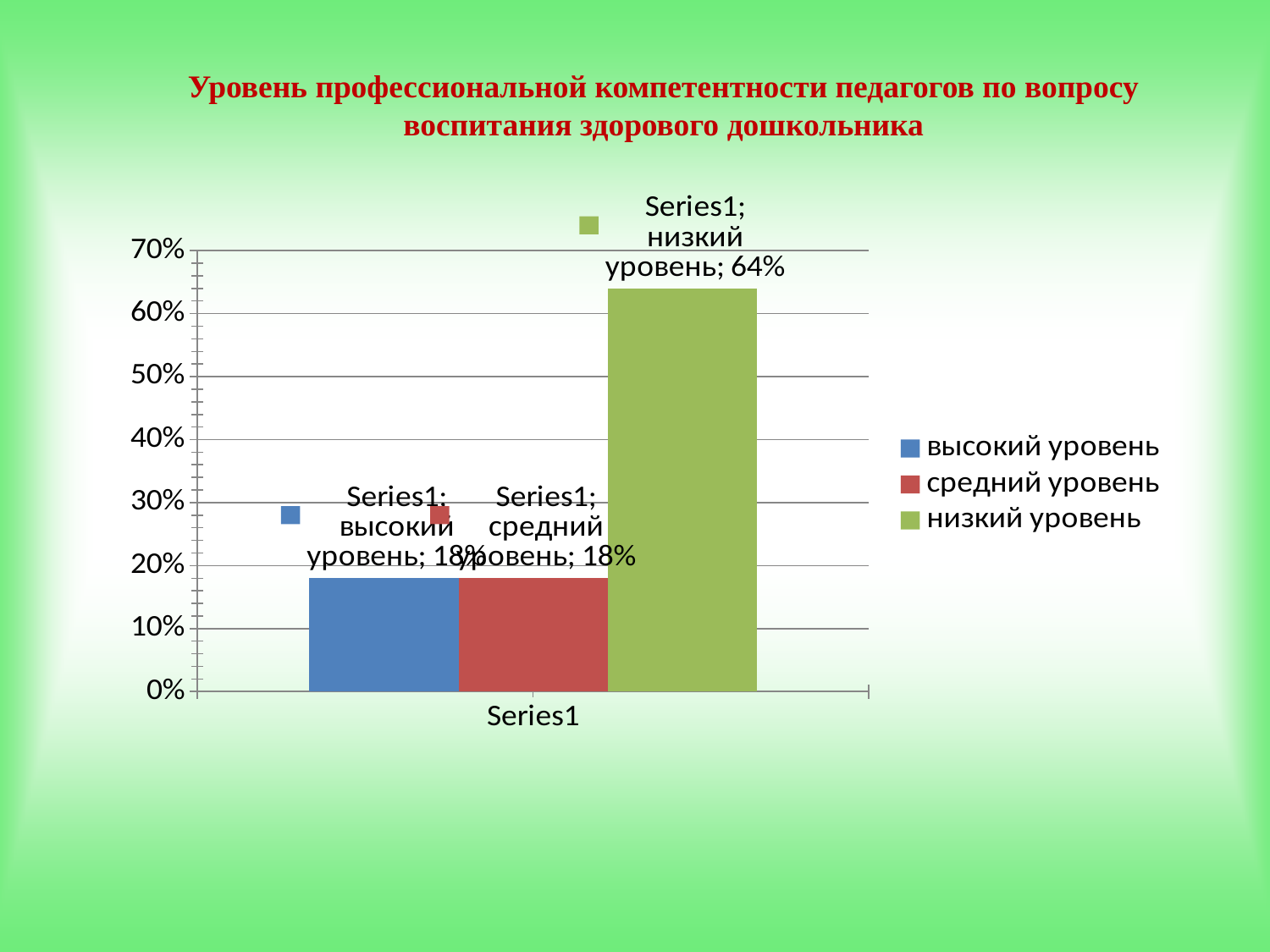
What kind of chart is shown on the slide? bar chart Which is larger, the value for низкий уровень or the value for средний уровень? низкий уровень What is the value for высокий уровень? 18% How many bars are plotted on the chart? 3 Is the value for высокий уровень greater or less than 20%? less What is the difference between the values for низкий уровень and высокий уровень? 46% How many entries does the legend list? 3 What is the value for средний уровень? 18% What colour is the bar for низкий уровень? green Is the value for низкий уровень greater or less than 60%? greater Which category has the highest value? низкий уровень What is the value for низкий уровень? 64%